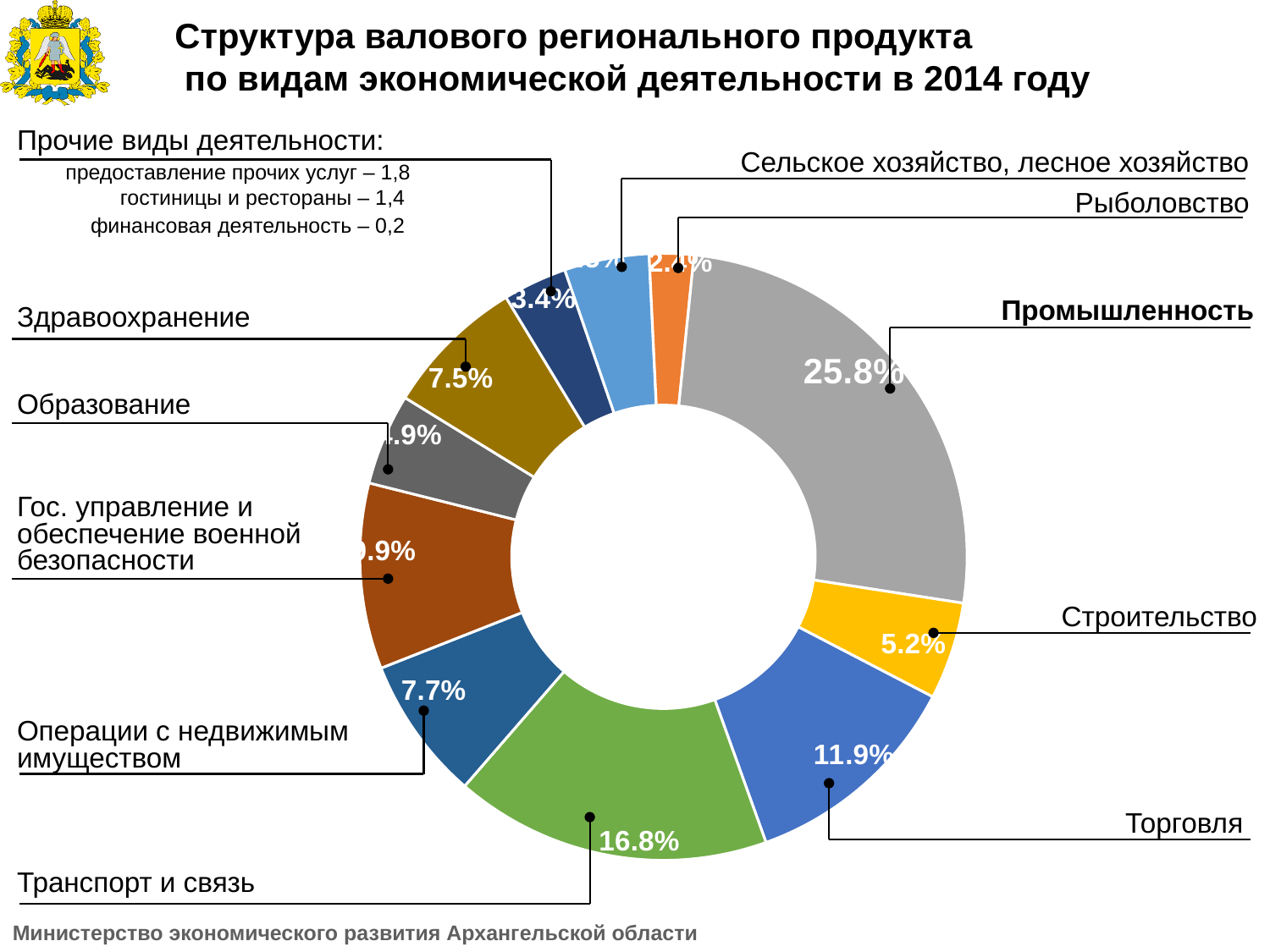
What share of the gross regional product does Промышленность account for? 25.8% How many sectors (slices) are shown in the chart? 11 Which sector has the smallest slice in the chart? Рыболовство What is the value shown for Транспорт и связь? 16.8% What is the value shown for Строительство? 5.2% What is the value shown for Здравоохранение? 7.5% Which is larger, the share of Торговля or the share of Строительство? Торговля Which sector has the largest share of the gross regional product? Промышленность What is the difference between the shares of Промышленность and Транспорт и связь? 9.0% What is the value shown for Торговля? 11.9% What is the value shown for Операции с недвижимым имуществом? 7.7% What kind of chart is shown on the slide? Pie chart (doughnut)